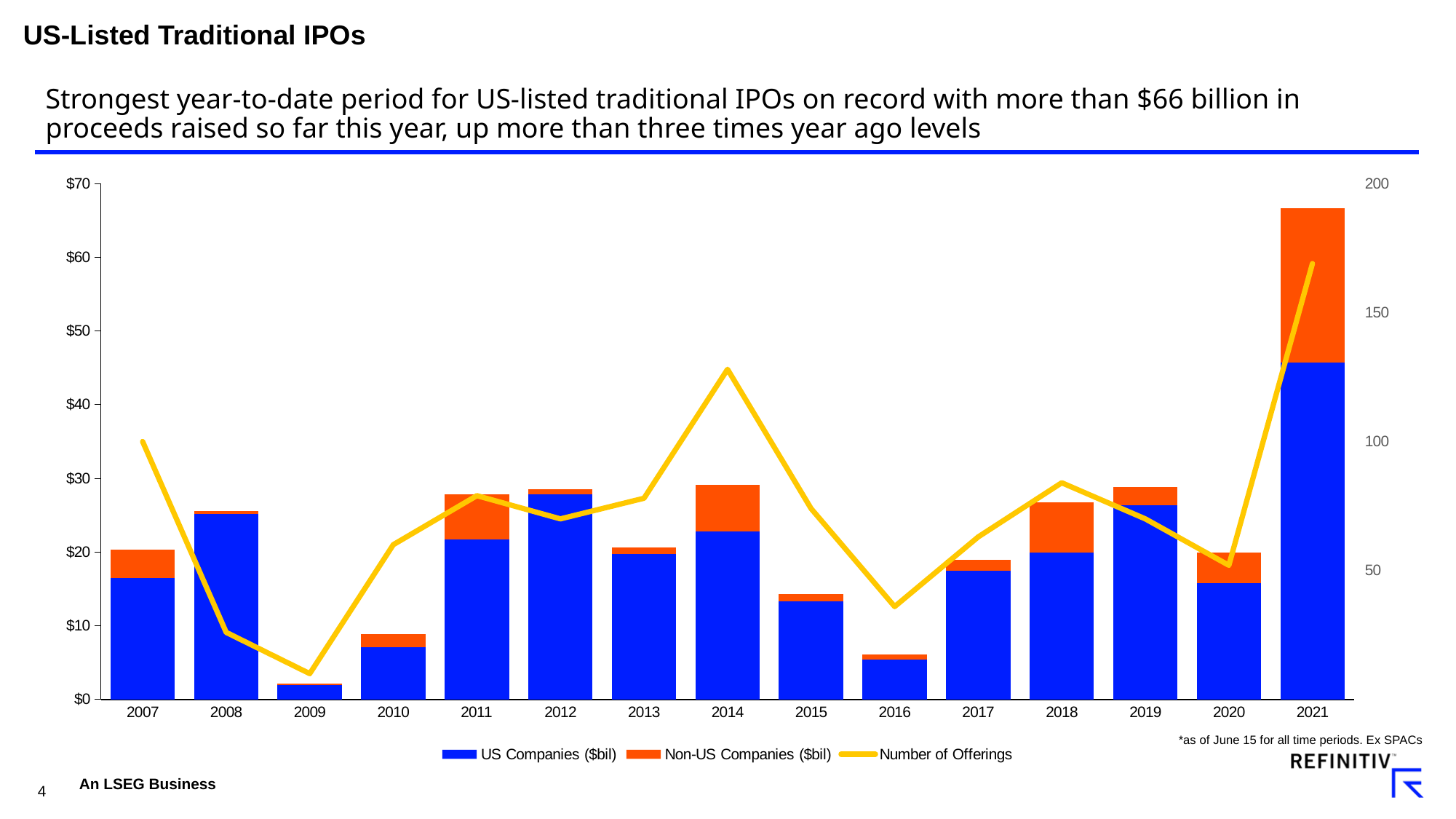
Which year has the highest Number of Offerings on the line? 2021 Which year has the tallest stacked bar (highest total proceeds)? 2021 What colour represents US Companies ($bil) in the chart? blue Is the Number of Offerings value for 2014 greater or less than 100? greater What kind of chart is shown on the slide? bar chart with a line How many years are shown on the x axis of the chart? 15 Is the total stacked bar for 2009 greater or less than $10? less Is the total stacked bar for 2021 greater or less than $60? greater Which year has the shortest stacked bar (lowest total proceeds)? 2009 Which year has the lowest Number of Offerings on the line? 2009 How many series does the chart's legend list? 3 Which year has a taller stacked bar, 2008 or 2010? 2008